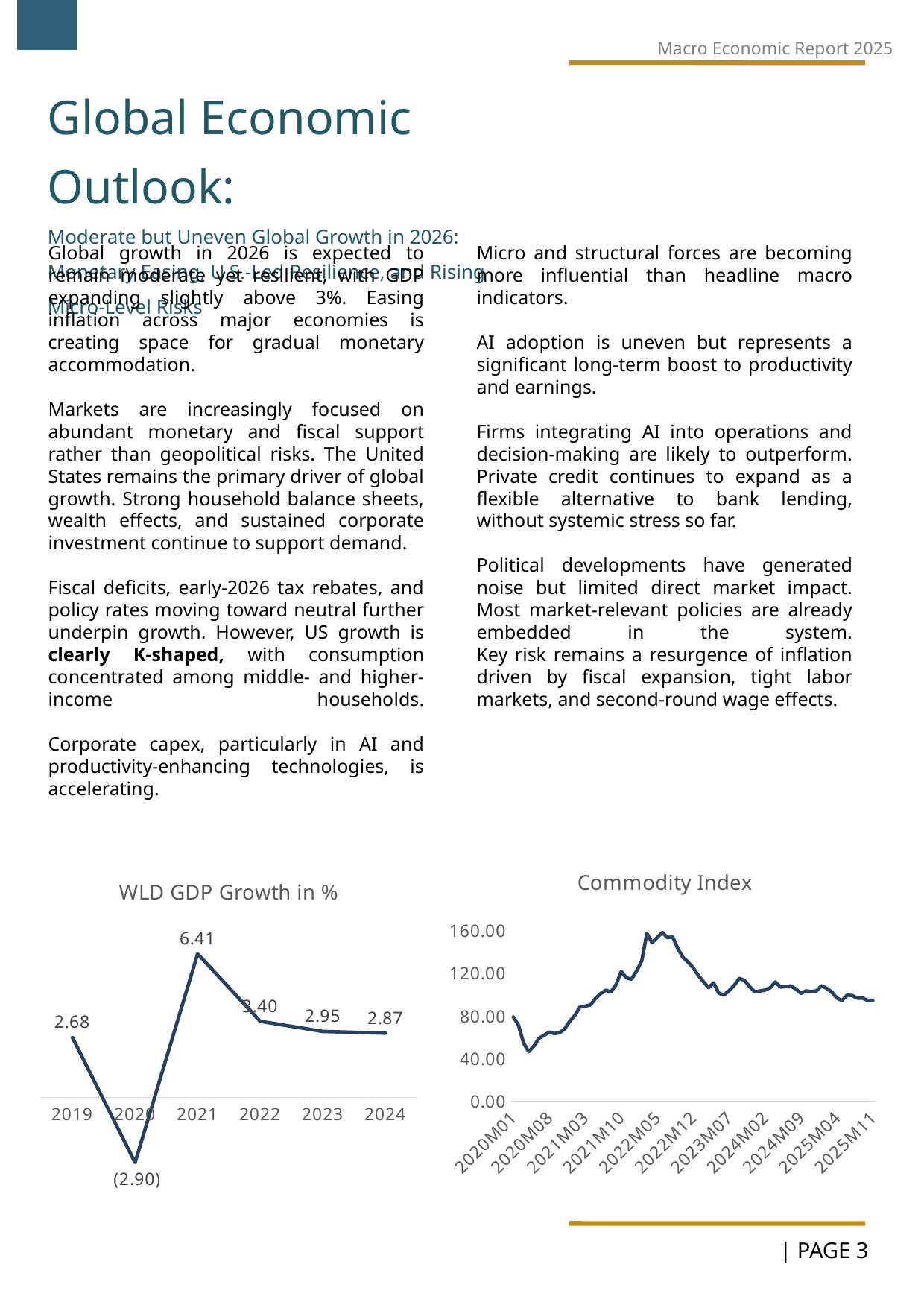
In the Commodity Index chart, is the peak value around 2022M05 greater or less than 120.00? greater In the Commodity Index chart, is the value at 2025M11 greater or less than 120.00? less In the WLD GDP Growth in % chart, which year has the highest value? 2021 In the WLD GDP Growth in % chart, what is the difference between the 2021 and 2022 values? 3.01 In the WLD GDP Growth in % chart, what is the value for 2024? 2.87 In the WLD GDP Growth in % chart, what is the value for 2021? 6.41 How many years are plotted in the WLD GDP Growth in % chart? 6 In the WLD GDP Growth in % chart, which is larger, the value for 2019 or the value for 2024? 2024 In the WLD GDP Growth in % chart, what is the value for 2020? (2.90) What kind of chart is the WLD GDP Growth in % chart? Line chart In the WLD GDP Growth in % chart, which year has the lowest value? 2020 In the WLD GDP Growth in % chart, do the values rise or fall from 2021 to 2024? Fall